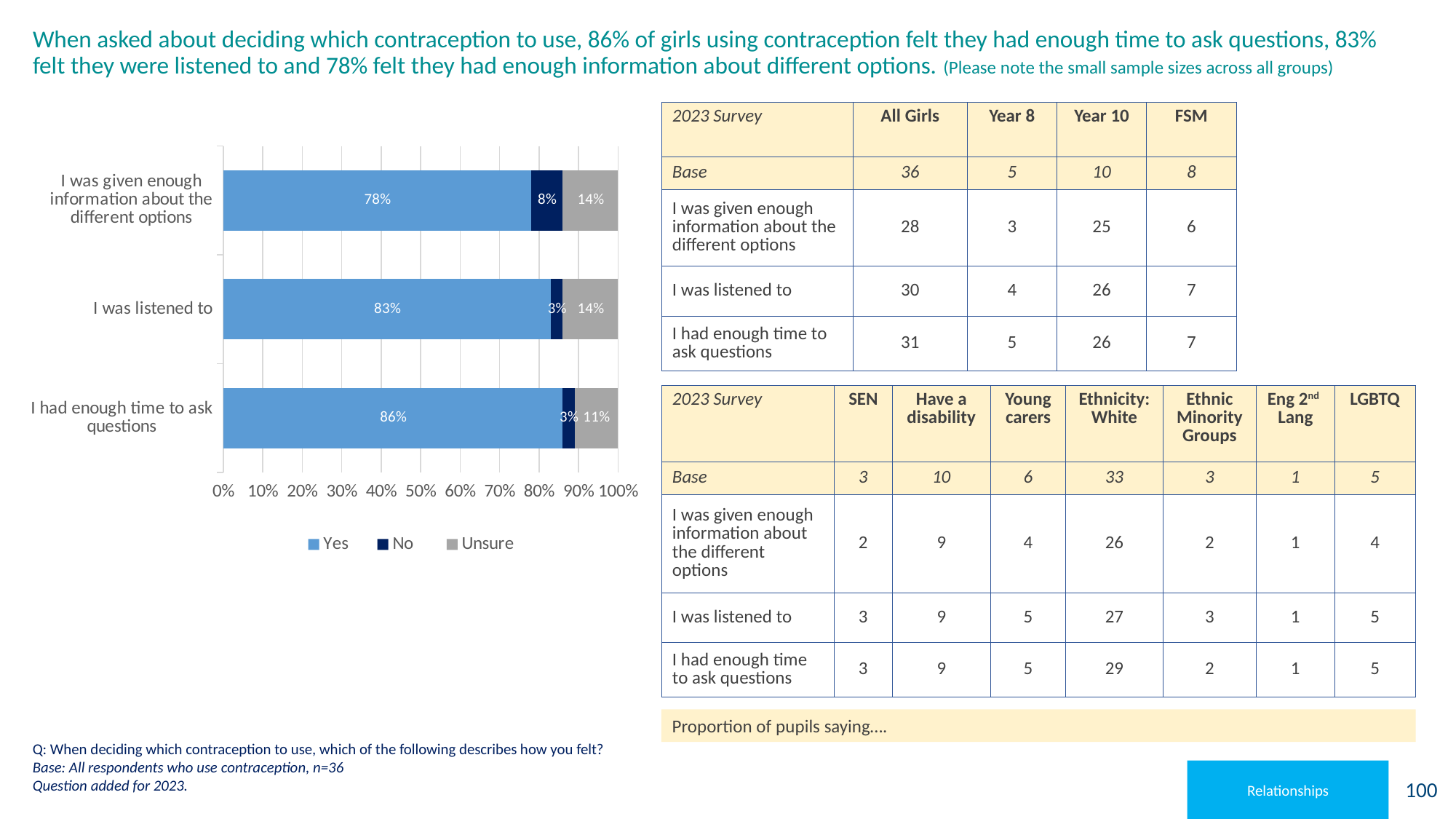
How many series does the chart legend list? 3 Which statement has the highest 'Yes' percentage? I had enough time to ask questions What are the three legend entries in the chart? Yes, No, Unsure What percentage of girls said 'Yes' to 'I had enough time to ask questions'? 86% Which statement has the lowest 'Yes' percentage? I was given enough information about the different options What percentage of girls said 'Yes' to 'I was given enough information about the different options'? 78% What percentage of girls said 'No' to 'I was given enough information about the different options'? 8% Which is larger: the 'Unsure' share for 'I was listened to' or for 'I had enough time to ask questions'? I was listened to What percentage of girls were 'Unsure' for 'I was listened to'? 14% What is the difference between the 'Yes' percentages for 'I had enough time to ask questions' and 'I was given enough information about the different options'? 8% How many statements (categories) are shown in the bar chart? 3 What type of chart is shown on the slide? Stacked bar chart